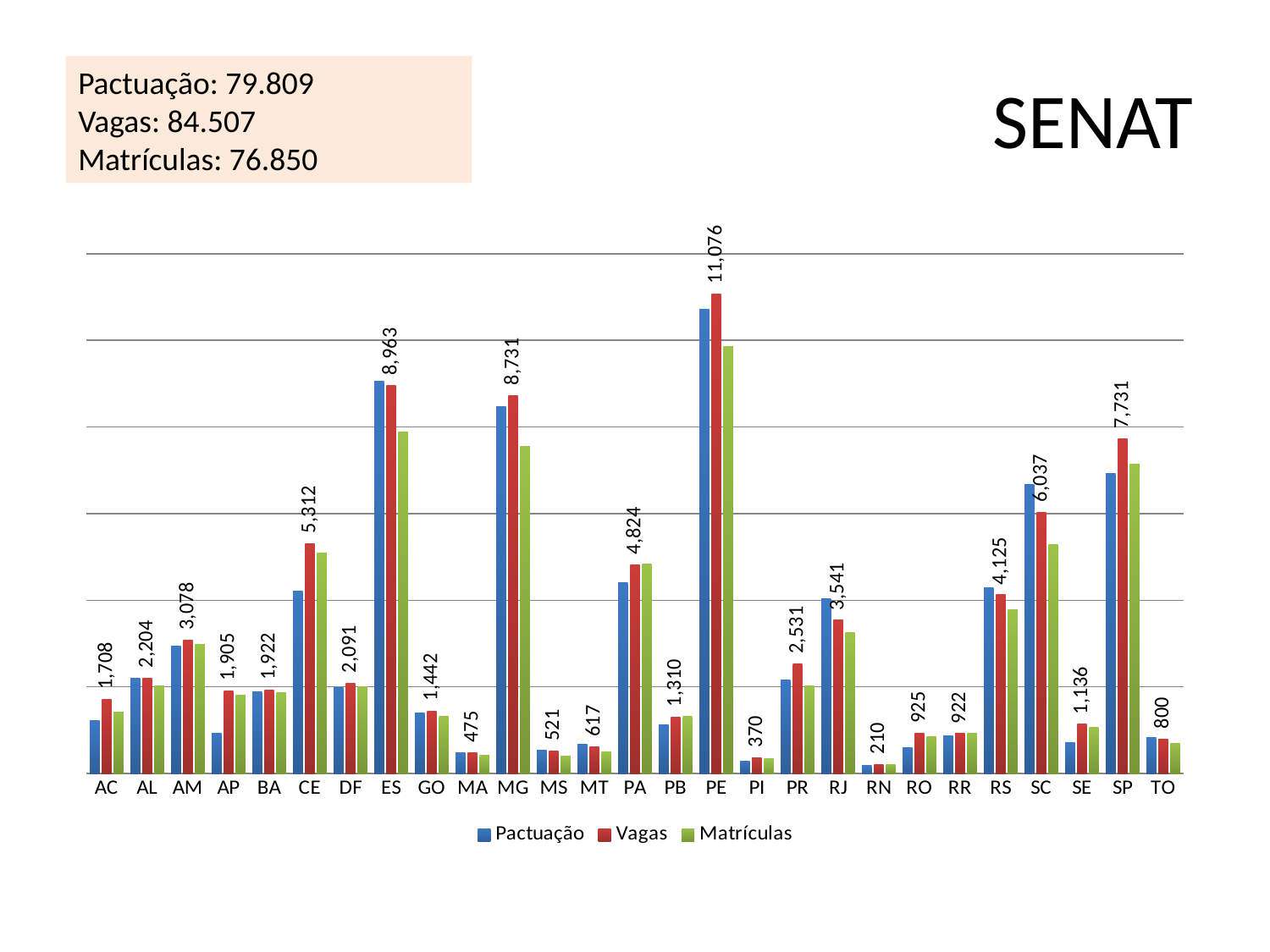
Which state has the lowest Vagas value? RN What kind of chart is shown on the slide? bar chart How many state categories are shown along the x axis? 27 Which has a larger Vagas value, SP or SC? SP What is the title of the slide containing the chart? SENAT What is the Vagas value for PE? 11,076 Which state has the highest Vagas value? PE How many series does the legend list? 3 What is the Vagas value for SP? 7,731 What is the Vagas value for RN? 210 What is the difference between the Vagas values for PE and ES? 2,113 What is the Vagas value for ES? 8,963